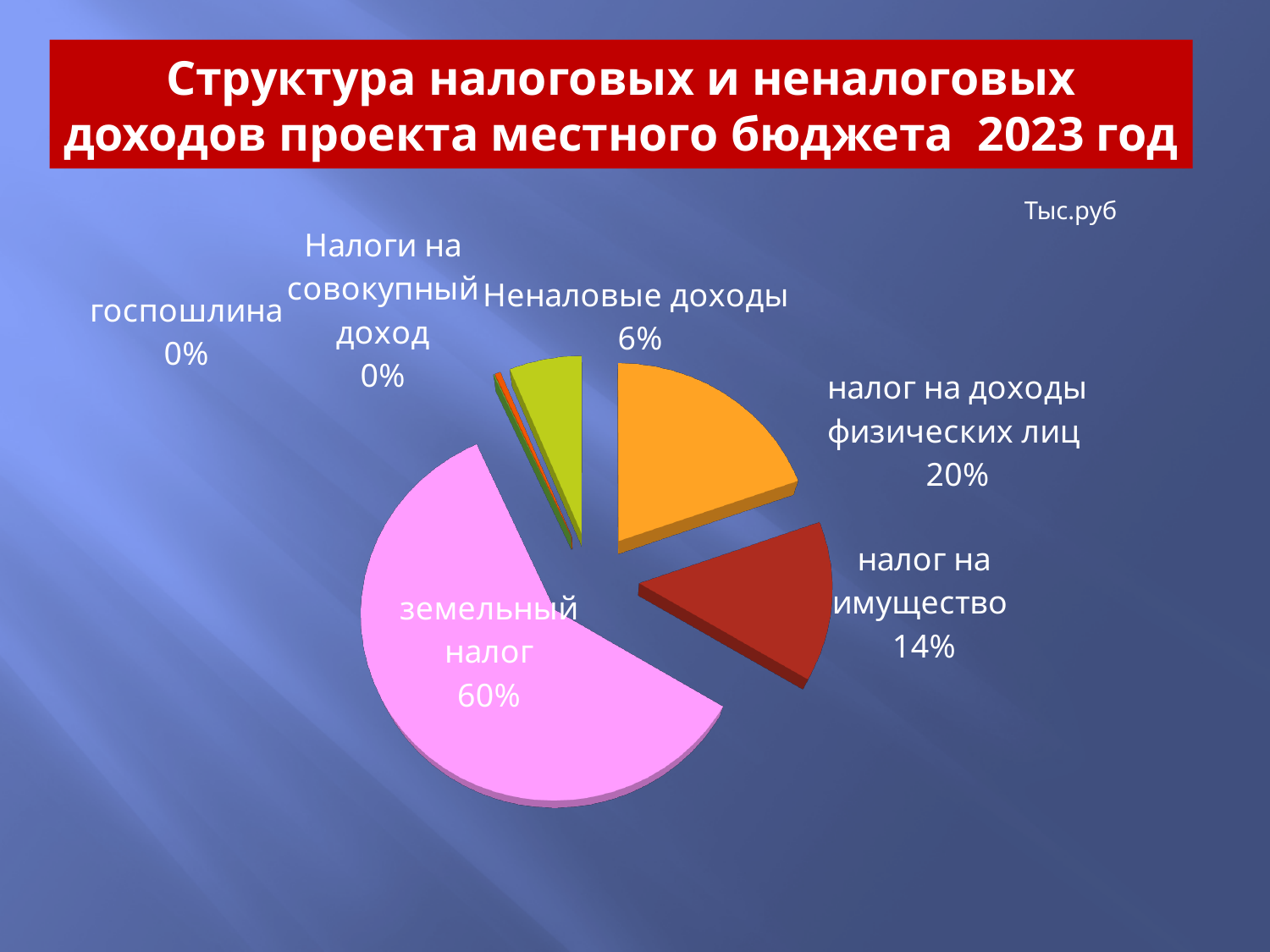
What share of the pie does госпошлина have? 0% What share of the pie does земельный налог have? 60% What is the difference in percentage points between the share for земельный налог and the share for налог на доходы физических лиц? 40 Which category has the largest share of the pie? земельный налог What share of the pie does налог на доходы физических лиц have? 20% What is the difference in percentage points between the share for налог на доходы физических лиц and the share for налог на имущество? 6 What kind of chart is shown on the slide? pie chart Which is larger: the share for налог на имущество or the share for Неналовые доходы? налог на имущество How many categories are shown in the pie chart? 6 What is the title of the chart on the slide? Структура налоговых и неналоговых доходов проекта местного бюджета 2023 год